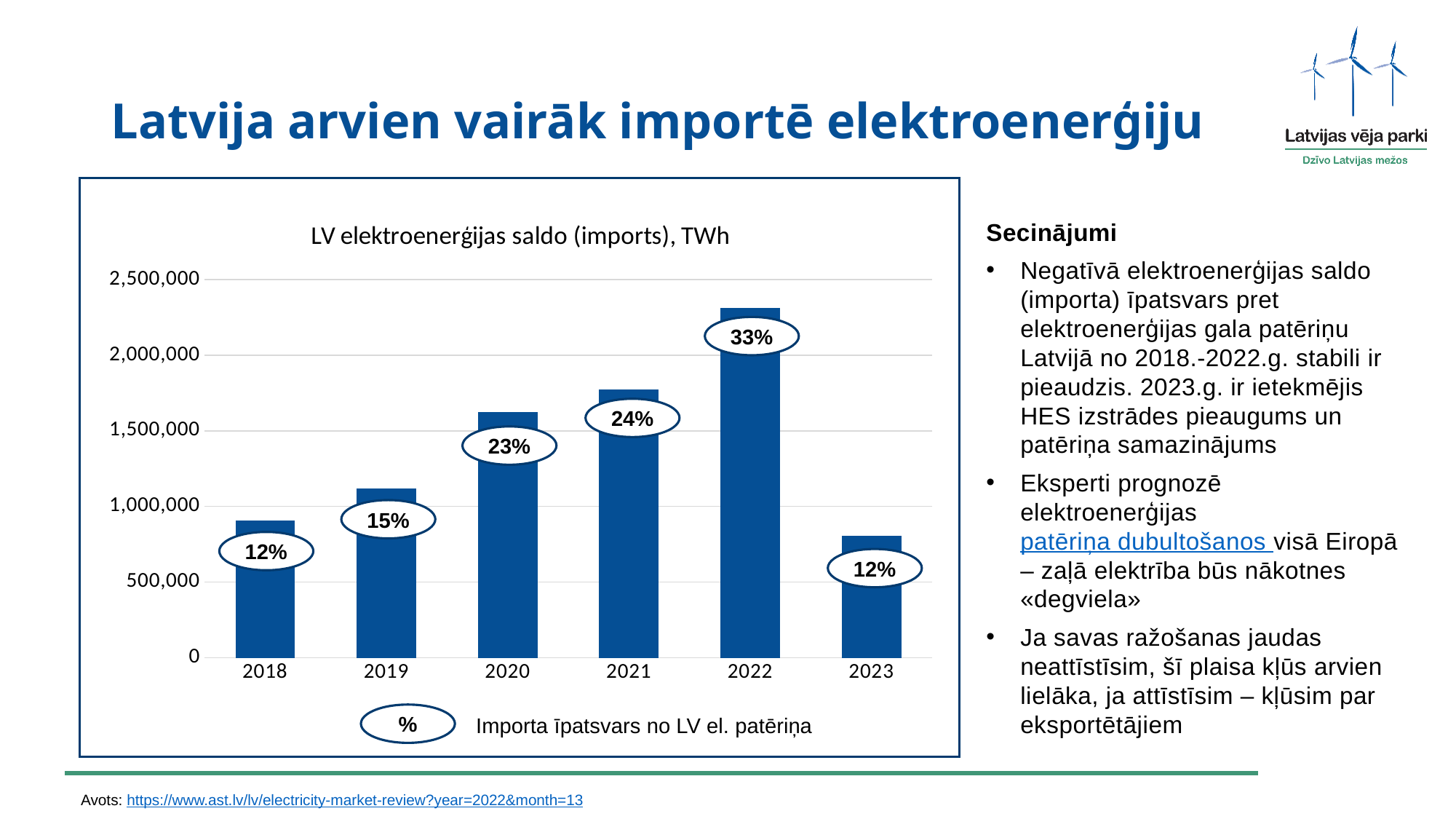
Is the value for 2022 greater or less than 2,000,000? greater Which year has the larger bar, 2019 or 2021? 2021 What import share percentage is labelled on the 2020 bar? 23% What kind of chart is shown on the slide? bar chart What is the title of the chart? LV elektroenerģijas saldo (imports), TWh What import share percentage is labelled on the 2019 bar? 15% How many years are shown on the x axis of the chart? 6 Which year has the lowest bar in the chart? 2023 Which year has the highest bar in the chart? 2022 Is the value for 2018 greater or less than 1,000,000? less What import share percentage is labelled on the 2022 bar? 33% Do the bar values rise or fall from 2018 to 2022? rise